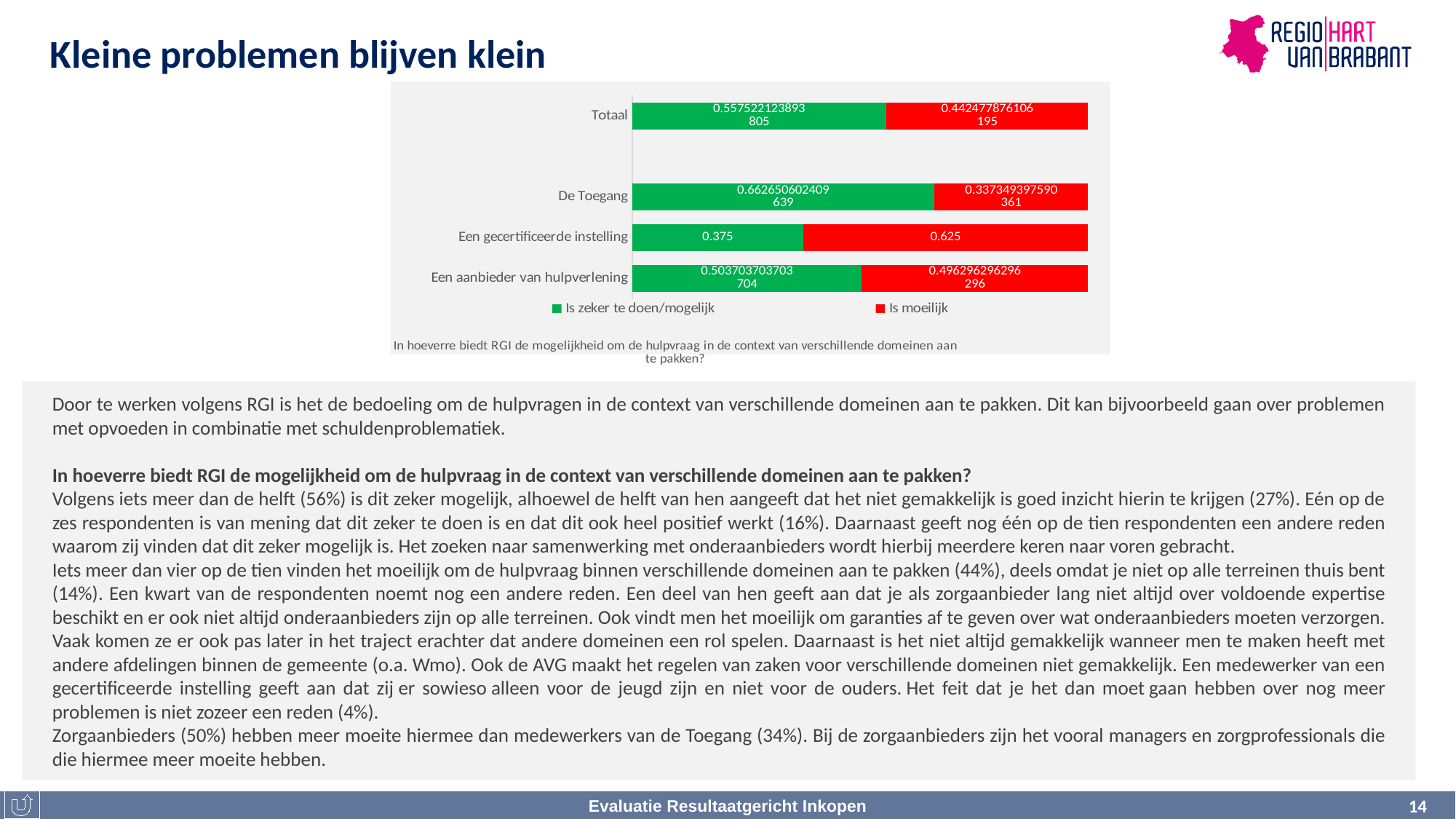
For 'Een aanbieder van hulpverlening', which segment is larger: 'Is zeker te doen/mogelijk' or 'Is moeilijk'? Is zeker te doen/mogelijk For 'Een gecertificeerde instelling', what is the difference between the 'Is moeilijk' and 'Is zeker te doen/mogelijk' values? 0.25 Which category has the largest 'Is zeker te doen/mogelijk' share? De Toegang What is the value of the 'Is moeilijk' segment for 'Een gecertificeerde instelling'? 0.625 How many series does the chart legend list? 2 What kind of chart is shown on the slide? Stacked horizontal bar chart What is the total of the stacked bar for 'Een gecertificeerde instelling'? 1 What is the value of the 'Is zeker te doen/mogelijk' segment for 'De Toegang'? 0.662650602409 What is the value of the 'Is zeker te doen/mogelijk' segment for 'Een gecertificeerde instelling'? 0.375 Which colour represents the 'Is moeilijk' series in the chart? Red How many categories are shown on the vertical axis of the chart? 4 Which category has the smallest 'Is zeker te doen/mogelijk' share? Een gecertificeerde instelling